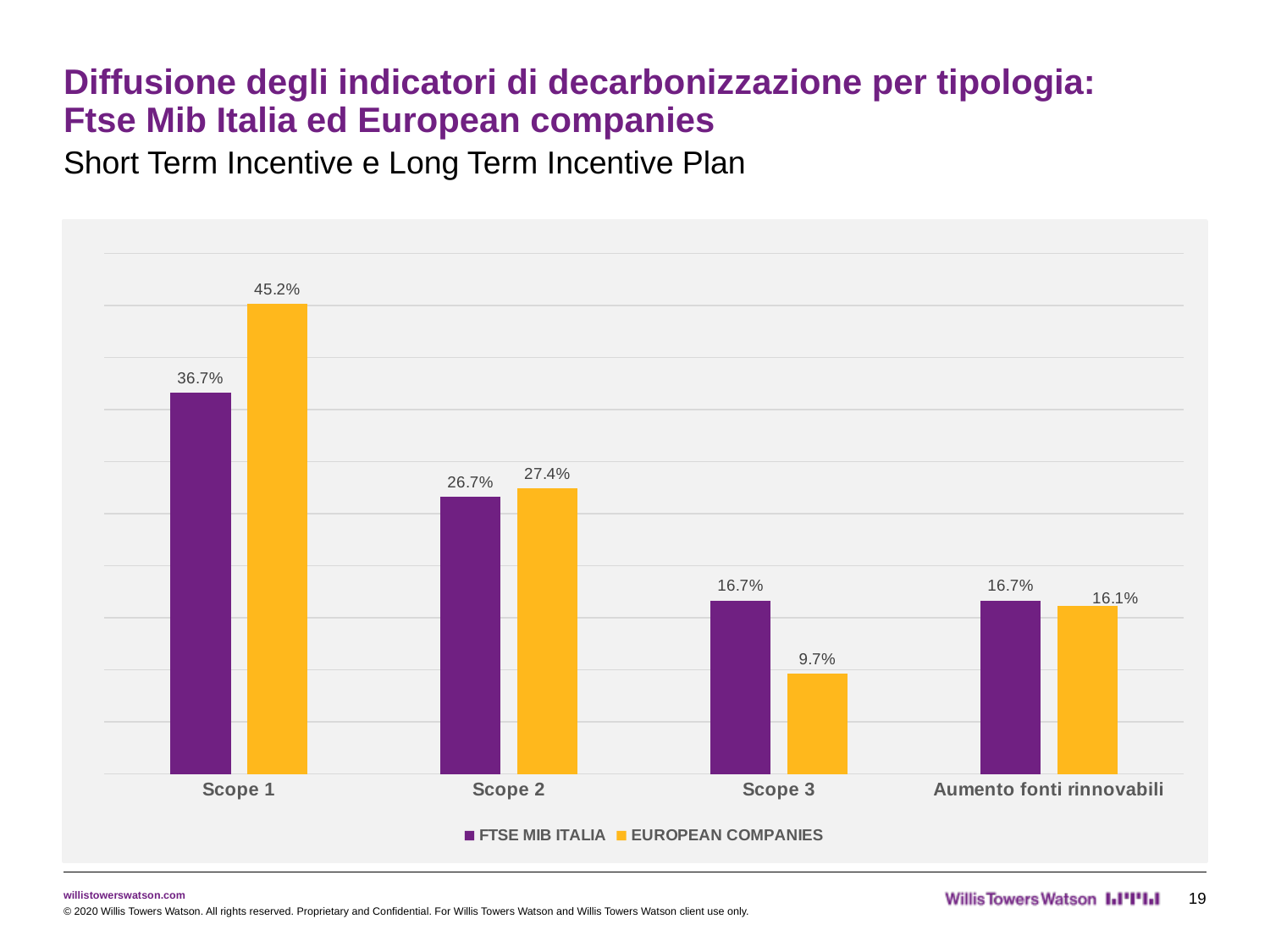
What is the difference between the FTSE MIB ITALIA and EUROPEAN COMPANIES values for Scope 3? 7.0% Which is larger for Scope 2: FTSE MIB ITALIA or EUROPEAN COMPANIES? EUROPEAN COMPANIES How many categories are shown on the x axis? 4 Which category has the highest value for EUROPEAN COMPANIES? Scope 1 Which category has the lowest value for EUROPEAN COMPANIES? Scope 3 What is the difference between the EUROPEAN COMPANIES and FTSE MIB ITALIA values for Scope 1? 8.5% What is the value for FTSE MIB ITALIA in the Scope 1 category? 36.7% What is the value for EUROPEAN COMPANIES in the Aumento fonti rinnovabili category? 16.1% What kind of chart is shown on the slide? Bar chart How many series does the legend list? 2 Which colour represents the EUROPEAN COMPANIES series? Yellow What is the value for EUROPEAN COMPANIES in the Scope 3 category? 9.7%